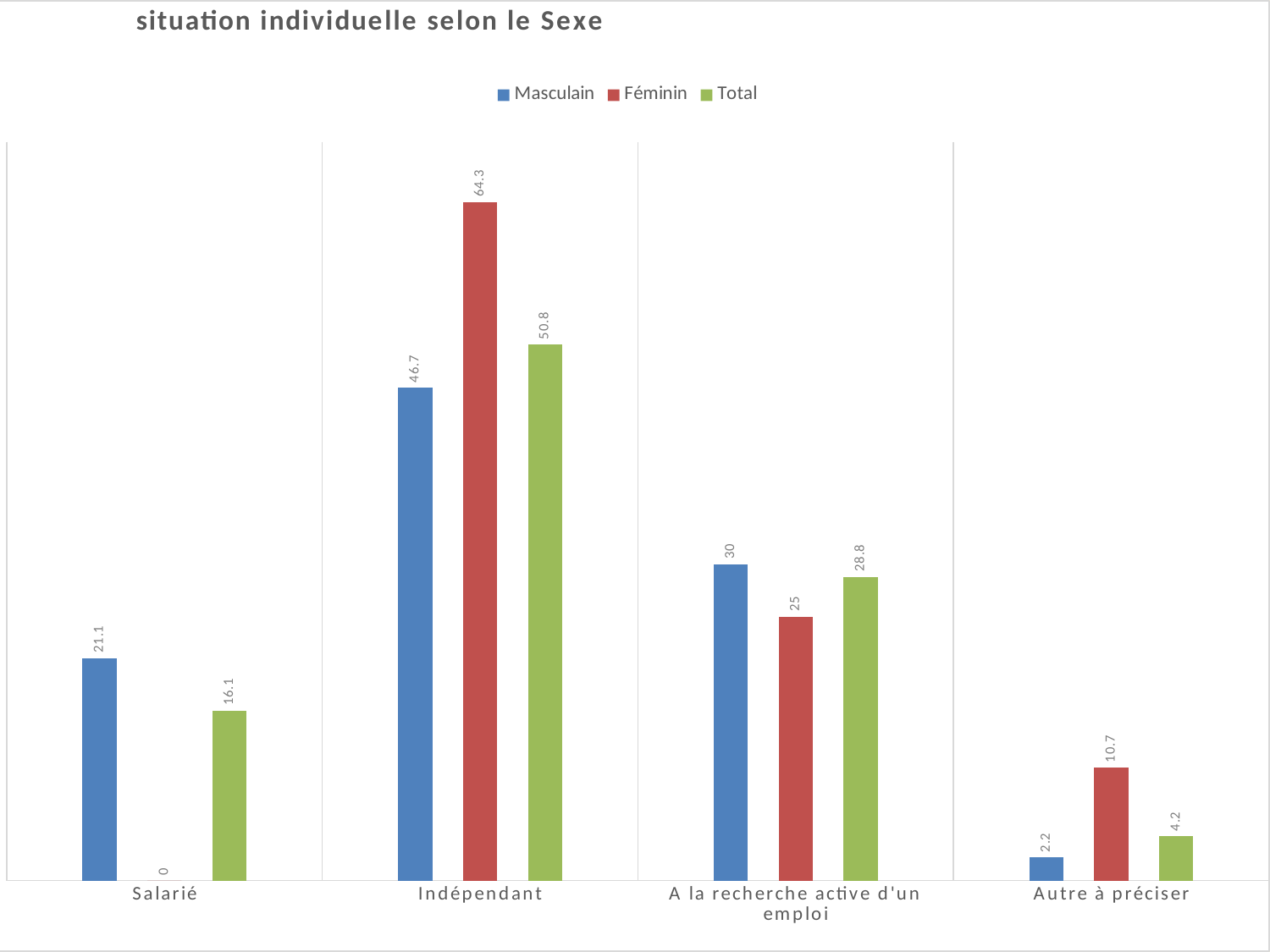
What is the Total value for A la recherche active d'un emploi? 28.8 How many series does the legend list? 3 How many categories are shown on the x axis? 4 Which category has the highest Total value? Indépendant What is the Féminin value for Indépendant? 64.3 What kind of chart is this? Bar chart What is the Masculain value for Salarié? 21.1 Which category has the lowest Masculain value? Autre à préciser What is the difference between the Féminin and Masculain values for Indépendant? 17.6 For A la recherche active d'un emploi, which is larger: Masculain or Féminin? Masculain What is the Féminin value for Autre à préciser? 10.7 What is the Féminin value for Salarié? 0